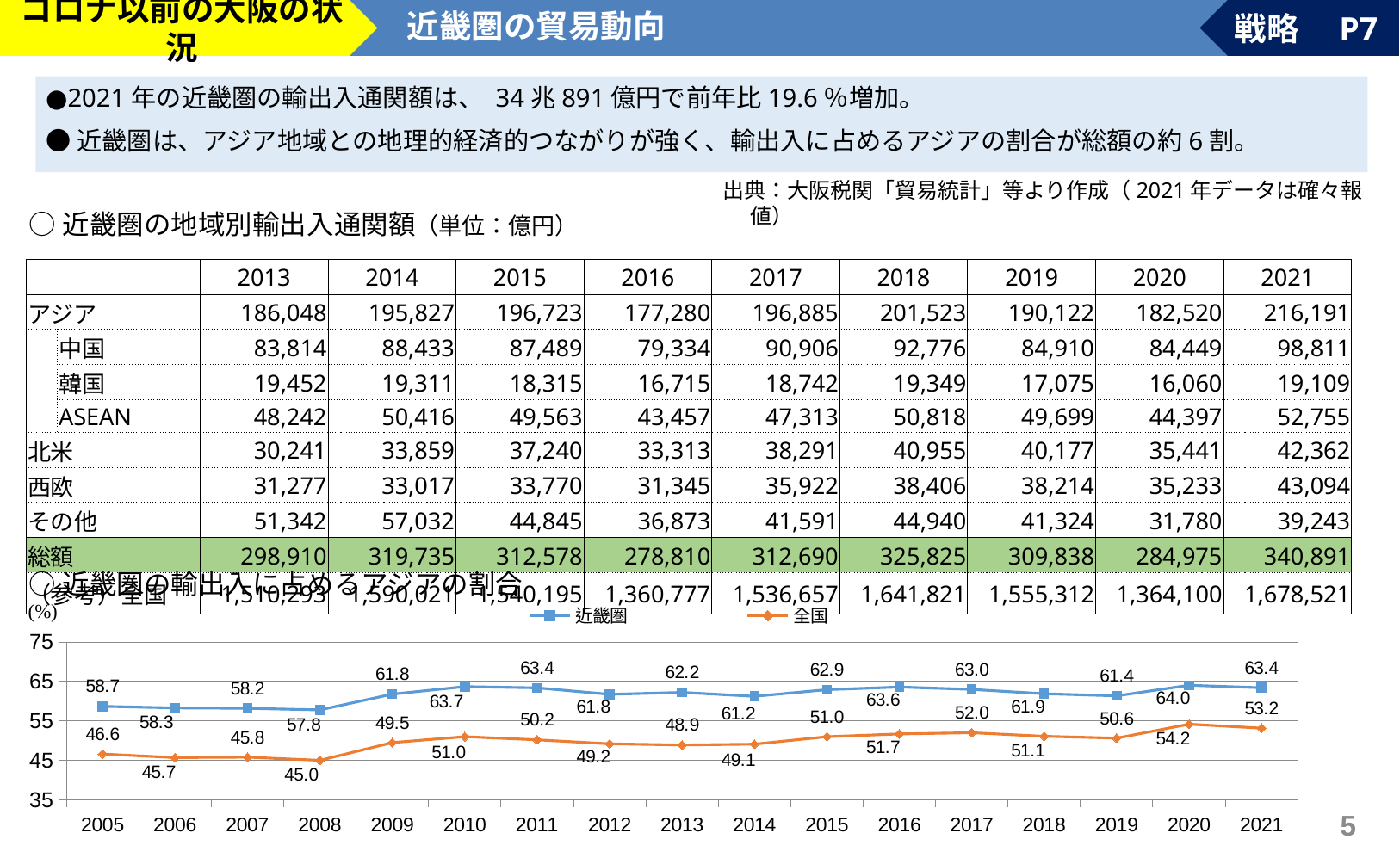
How many series does the legend of the line chart list? 2 In the line chart, what is the value for 近畿圏 in 2021? 63.4 In the line chart, which series is drawn in orange? 全国 In the line chart, in which year is the 全国 series lowest? 2008 In the line chart, does the 近畿圏 series rise or fall from 2005 to 2008? fall In the line chart, what is the value for 全国 in 2008? 45.0 In the line chart, which series has the larger value in 2015, 近畿圏 or 全国? 近畿圏 In the line chart, what is the value for 近畿圏 in 2010? 63.7 How many years are plotted along the x axis of the line chart? 17 In the line chart, what is the difference between the 近畿圏 and 全国 values in 2021? 10.2 In the line chart, in which year is the 近畿圏 series highest? 2020 What type of chart is shown at the bottom of the slide? line chart